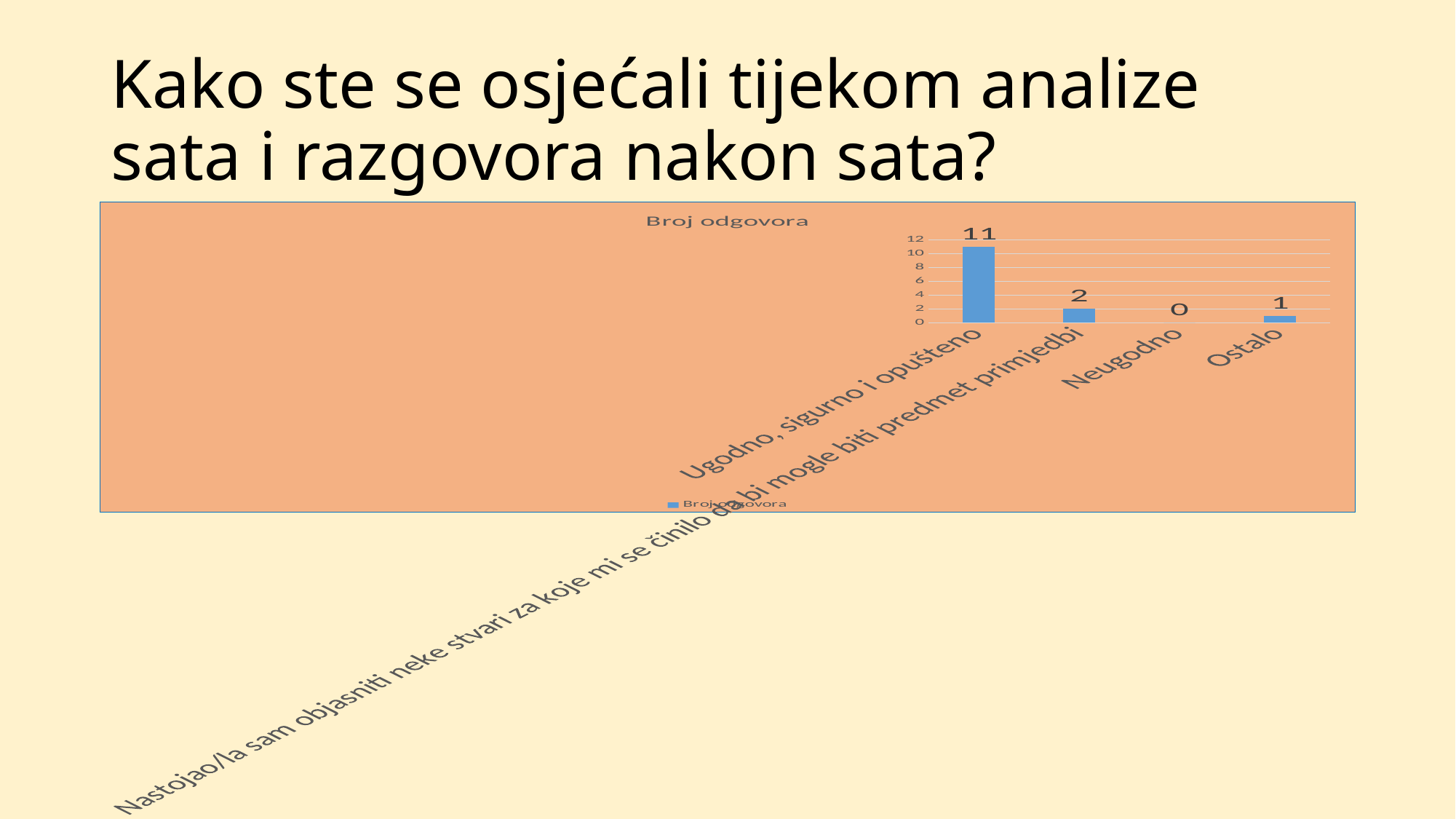
How many series does the legend list? 1 What is the value for "Neugodno"? 0 What is the value for "Ugodno, sigurno i opušteno"? 11 Which category has the lowest value? Neugodno What is the difference between the values for "Ugodno, sigurno i opušteno" and "Ostalo"? 10 What is the value for "Nastojao/la sam objasniti neke stvari za koje mi se činilo da bi mogle biti predmet primjedbi"? 2 Which category has the highest value? Ugodno, sigurno i opušteno What kind of chart is shown on the slide? bar chart What is the title of the chart? Broj odgovora Which is larger, the value for "Ostalo" or the value for "Nastojao/la sam objasniti neke stvari za koje mi se činilo da bi mogle biti predmet primjedbi"? Nastojao/la sam objasniti neke stvari za koje mi se činilo da bi mogle biti predmet primjedbi How many categories are shown on the x axis? 4 What is the value for "Ostalo"? 1